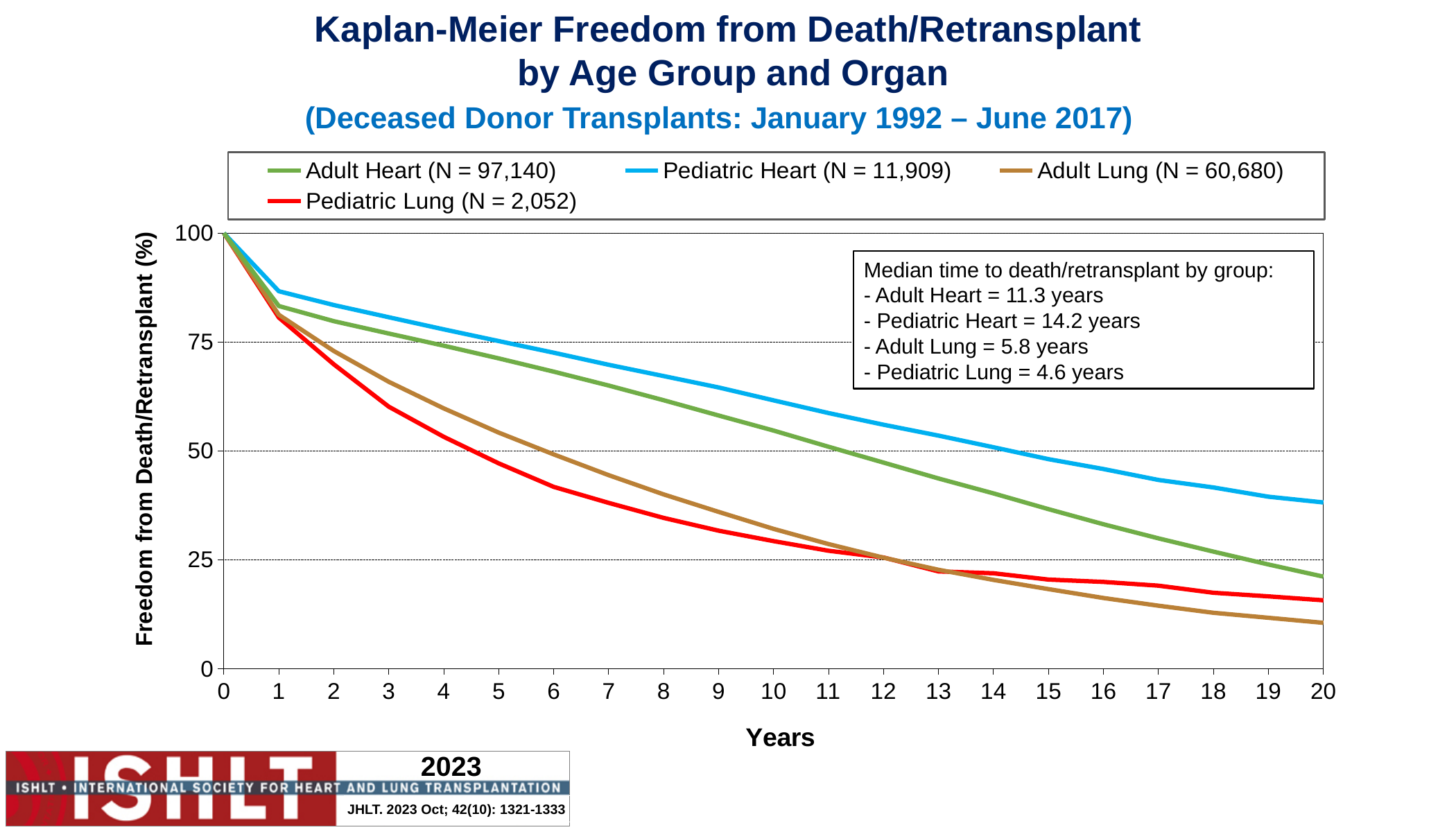
Which group has the highest freedom from death/retransplant at 20 years? Pediatric Heart Is the value for Adult Heart at 10 years greater or less than 50? greater At 5 years, which is larger: the value for Adult Lung or for Pediatric Lung? Adult Lung What is the N shown in the legend for Pediatric Lung? 2,052 Which group has the lowest freedom from death/retransplant at 20 years? Adult Lung What is the difference between the median time to death/retransplant for Pediatric Heart and for Adult Heart? 2.9 years How many series does the legend list? 4 Is the value for Adult Lung at 20 years greater or less than 25? less Do the curves rise or fall as the years increase along the x axis? fall What kind of chart is shown on the slide? line chart According to the annotation box, what is the median time to death/retransplant for Adult Lung? 5.8 years Is the value for Pediatric Heart at 20 years greater or less than 25? greater